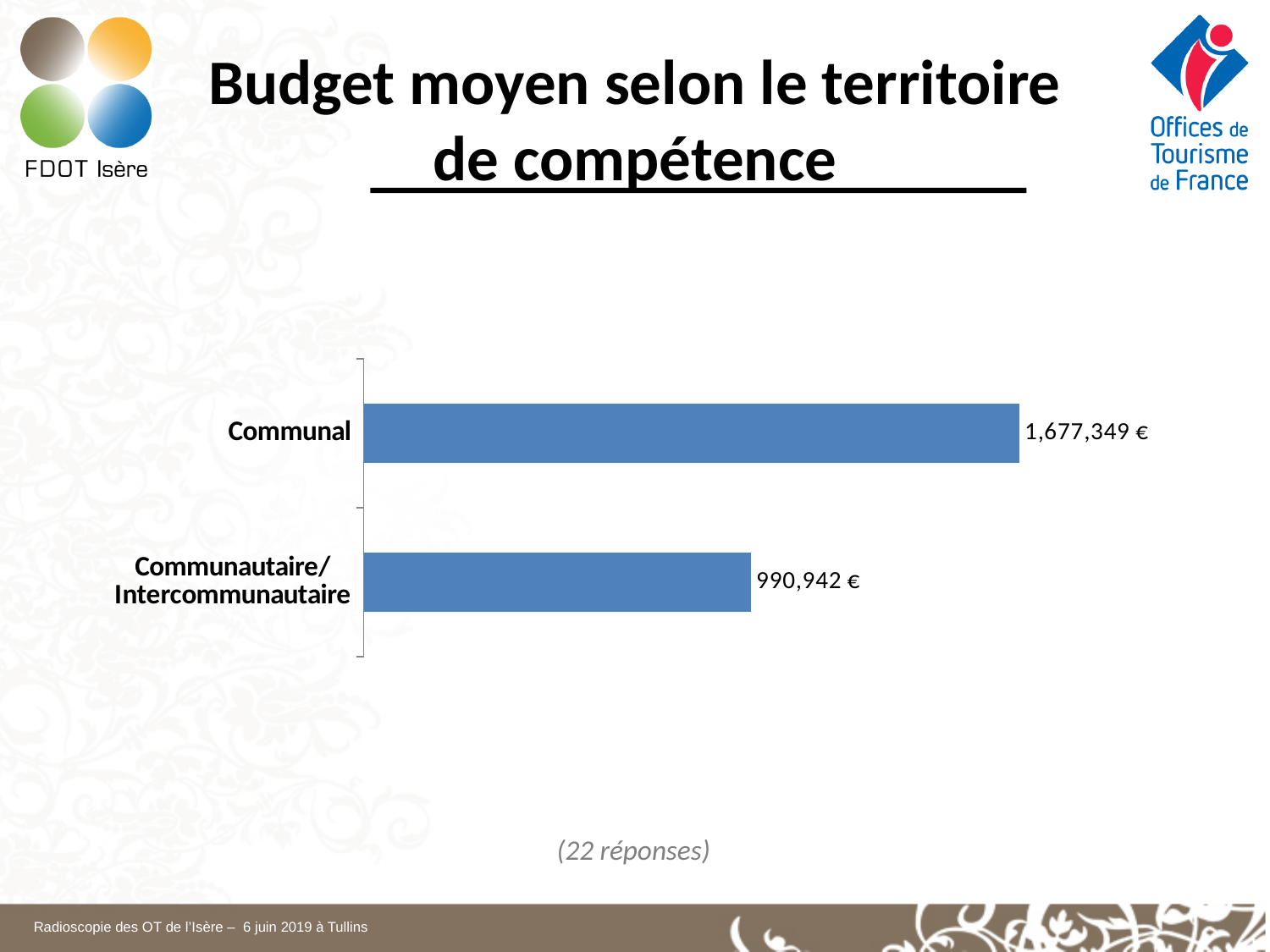
What kind of chart is shown on the slide? Bar chart How many responses does the chart note say it is based on? 22 réponses Which is larger: the average budget for Communal or for Communautaire/Intercommunautaire? Communal What is the title of the slide containing the chart? Budget moyen selon le territoire de compétence What is the difference between the average budget for Communal and for Communautaire/Intercommunautaire? 686,407 € Which territory of competence has the lowest average budget? Communautaire/Intercommunautaire Which territory of competence has the highest average budget? Communal What is the average budget shown for Communal? 1,677,349 € How many categories are shown in the chart? 2 What is the average budget shown for Communautaire/Intercommunautaire? 990,942 €